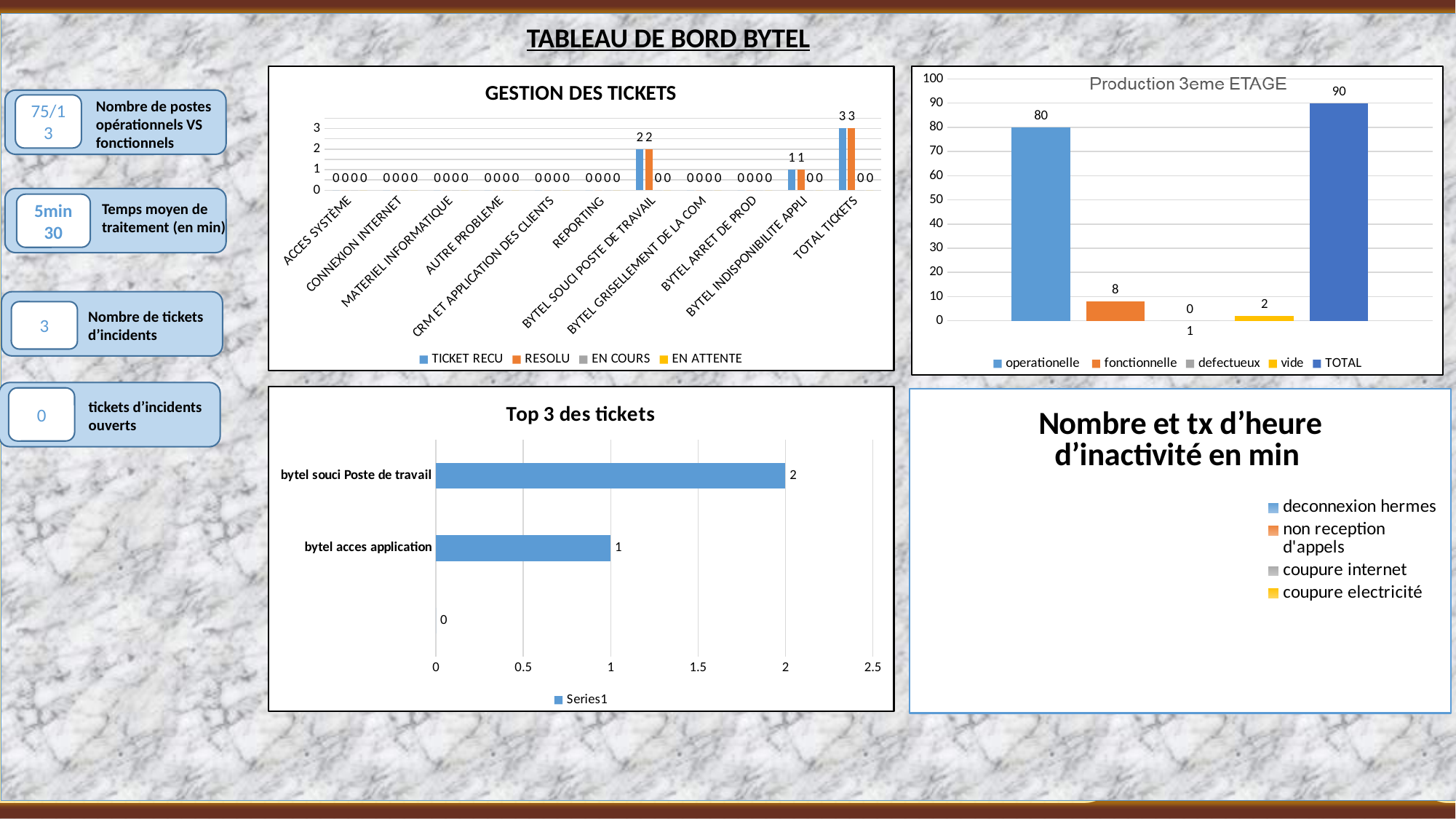
In the 'Production 3eme ETAGE' chart, what is the difference between TOTAL and operationelle? 10 How many categories are shown on the x axis of the 'GESTION DES TICKETS' chart? 11 What kind of chart is 'Top 3 des tickets'? bar chart In the 'GESTION DES TICKETS' chart, what is the TICKET RECU value for TOTAL TICKETS? 3 In the 'Top 3 des tickets' chart, what is the value for bytel souci Poste de travail? 2 In the 'Production 3eme ETAGE' chart, what is the value for fonctionnelle? 8 In the 'GESTION DES TICKETS' chart, what is the RESOLU value for BYTEL INDISPONIBILITE APPLI? 1 How many series does the legend of the 'GESTION DES TICKETS' chart list? 4 In the 'Production 3eme ETAGE' chart, what is the value for operationelle? 80 In the 'Production 3eme ETAGE' chart, which series has the highest value? TOTAL In the 'Top 3 des tickets' chart, which is larger: bytel souci Poste de travail or bytel acces application? bytel souci Poste de travail How many series does the legend of the 'Production 3eme ETAGE' chart list? 5